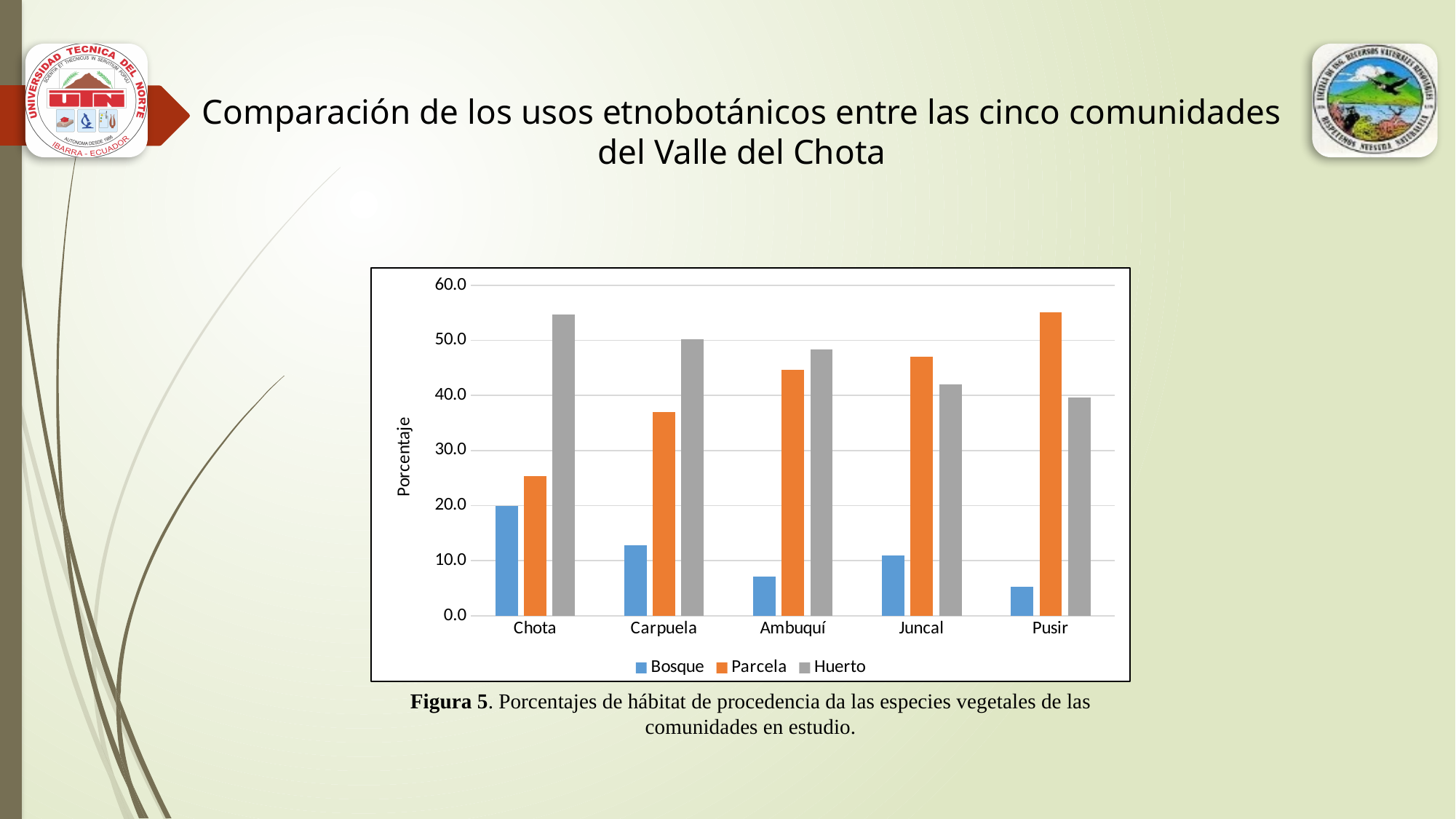
Which community has the lowest Bosque value? Pusir Which community has the highest Parcela value? Pusir Is the Huerto value for Carpuela greater or less than 40.0? greater Which community has the highest Huerto value? Chota How many communities are shown on the x axis? 5 How many series does the legend list? 3 Do the Huerto values rise or fall from Chota to Pusir along the x axis? fall For Chota, which is larger, Bosque or Parcela? Parcela What is the label on the y axis? Porcentaje Is the Bosque value for Ambuquí greater or less than 10.0? less For Pusir, which is larger, Parcela or Huerto? Parcela What kind of chart is shown on the slide? bar chart